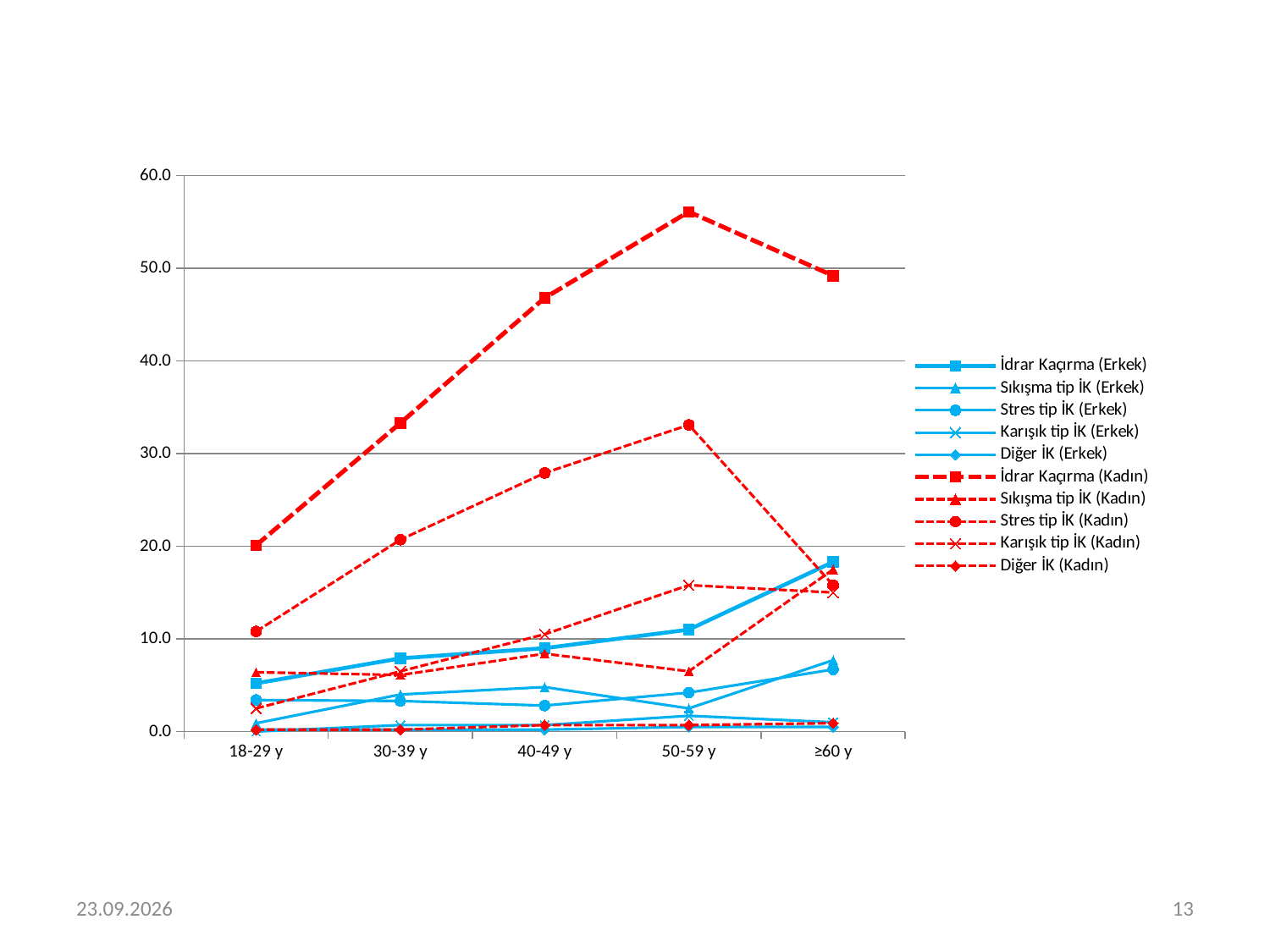
In which age group is İdrar Kaçırma (Kadın) lowest? 18-29 y What kind of chart is shown on the slide? line chart Is the value for Stres tip İK (Kadın) at 50-59 y greater or less than 30? greater How many age groups are shown on the x axis? 5 Is the value for İdrar Kaçırma (Kadın) at 40-49 y greater or less than 40? greater What colour and line style are used for the Kadın series in the legend? red dashed lines In which age group does İdrar Kaçırma (Kadın) reach its highest value? 50-59 y Is the value for İdrar Kaçırma (Kadın) at 50-59 y greater or less than 50? greater Does the İdrar Kaçırma (Erkek) line rise or fall from 18-29 y to ≥60 y? rise At 40-49 y, which is larger: İdrar Kaçırma (Kadın) or İdrar Kaçırma (Erkek)? İdrar Kaçırma (Kadın) How many series does the legend list? 10